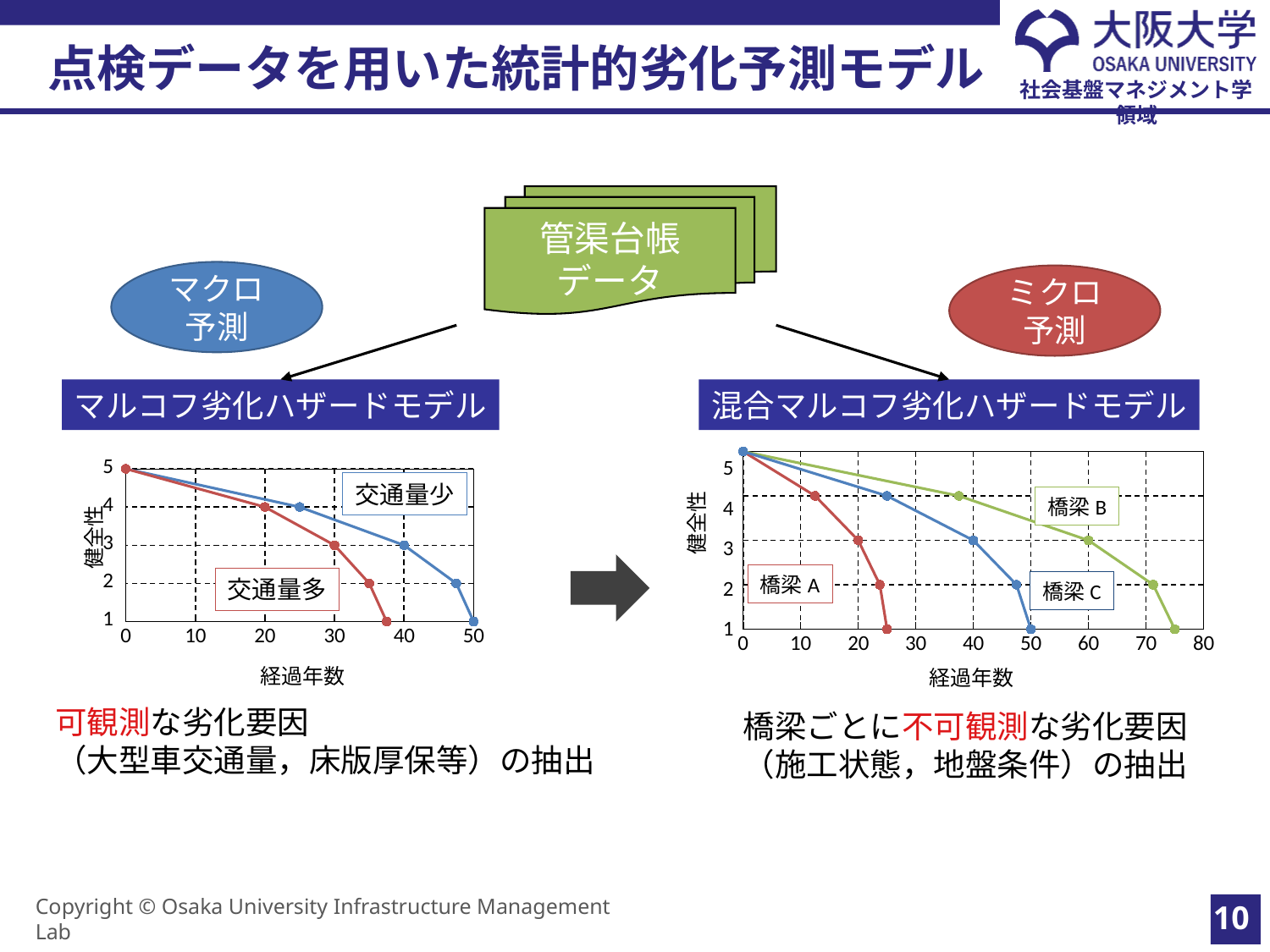
How many series are plotted in the left chart (マルコフ劣化ハザードモデル)? 2 In the right chart, which series reaches 健全性 1 at the smallest number of 経過年数? 橋梁 A What kind of chart is the right chart under 混合マルコフ劣化ハザードモデル? line chart In the right chart, which series reaches 健全性 1 at the largest number of 経過年数? 橋梁 B In the left chart, which series reaches 健全性 1 at a larger number of 経過年数, 交通量少 or 交通量多? 交通量少 What is the x-axis label of the right chart (混合マルコフ劣化ハザードモデル)? 経過年数 In the left chart, do the 健全性 values rise or fall as 経過年数 increases? fall In the right chart, do the 健全性 values for 橋梁 B rise or fall as 経過年数 increases? fall How many series are plotted in the right chart (混合マルコフ劣化ハザードモデル)? 3 In the right chart, is the 経過年数 at which 橋梁 B reaches 健全性 1 greater or less than 70? greater In the left chart, is the 経過年数 at which 交通量多 reaches 健全性 1 greater or less than 40? less What kind of chart is the left chart under マルコフ劣化ハザードモデル? line chart